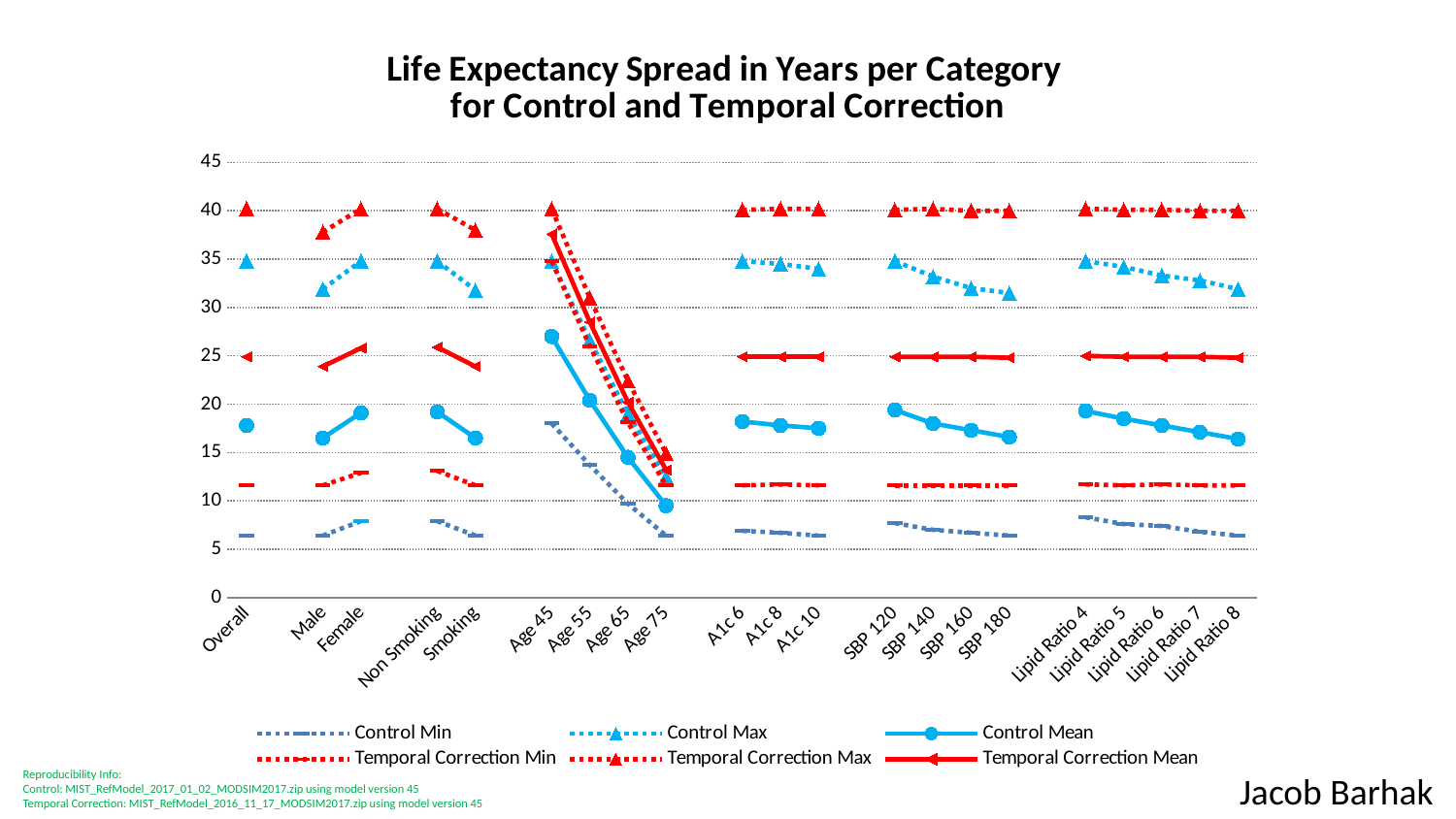
Which has the higher Control Mean value, Male or Female? Female How many series does the legend list? 6 Does the Control Mean rise or fall from Age 45 to Age 75? fall Which category has the lowest Control Max value? Age 75 Is the Control Max value for Age 75 greater or less than 15? less Which category has the highest Control Mean value? Age 45 How many categories are shown along the x axis? 21 What is the title of the chart? Life Expectancy Spread in Years per Category for Control and Temporal Correction Is the Control Min value for Age 45 greater or less than 15? greater What kind of chart is shown on the slide? line chart Which category has the lowest Control Mean value? Age 75 Is the Control Mean value for Age 45 greater or less than 25? greater